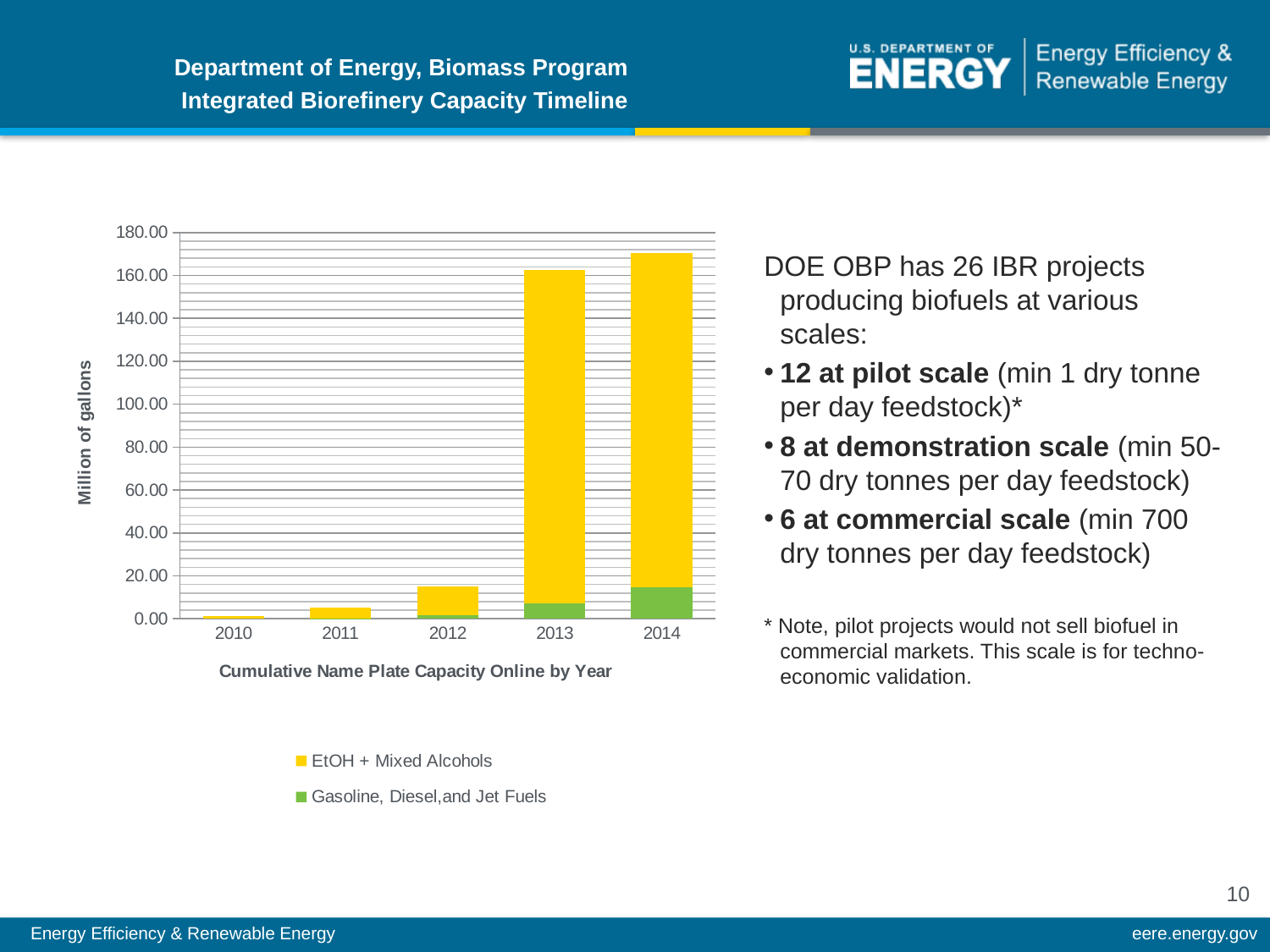
Is the total value for 2014 greater or less than 160? greater What is the label on the chart's vertical axis? Million of gallons How many series does the chart's legend list? 2 How many years are shown on the x axis of the chart? 5 Is the total value for 2012 greater or less than 20? less Which series is shown in green in the chart's legend? Gasoline, Diesel,and Jet Fuels What kind of chart is shown on the slide? stacked bar chart Is the total value for 2013 greater or less than 140? greater Do the total bar heights rise or fall from 2010 to 2014? rise Which year has the lowest total cumulative capacity? 2010 Which year has the highest total cumulative capacity? 2014 Which is larger, the total bar for 2012 or the total bar for 2013? 2013